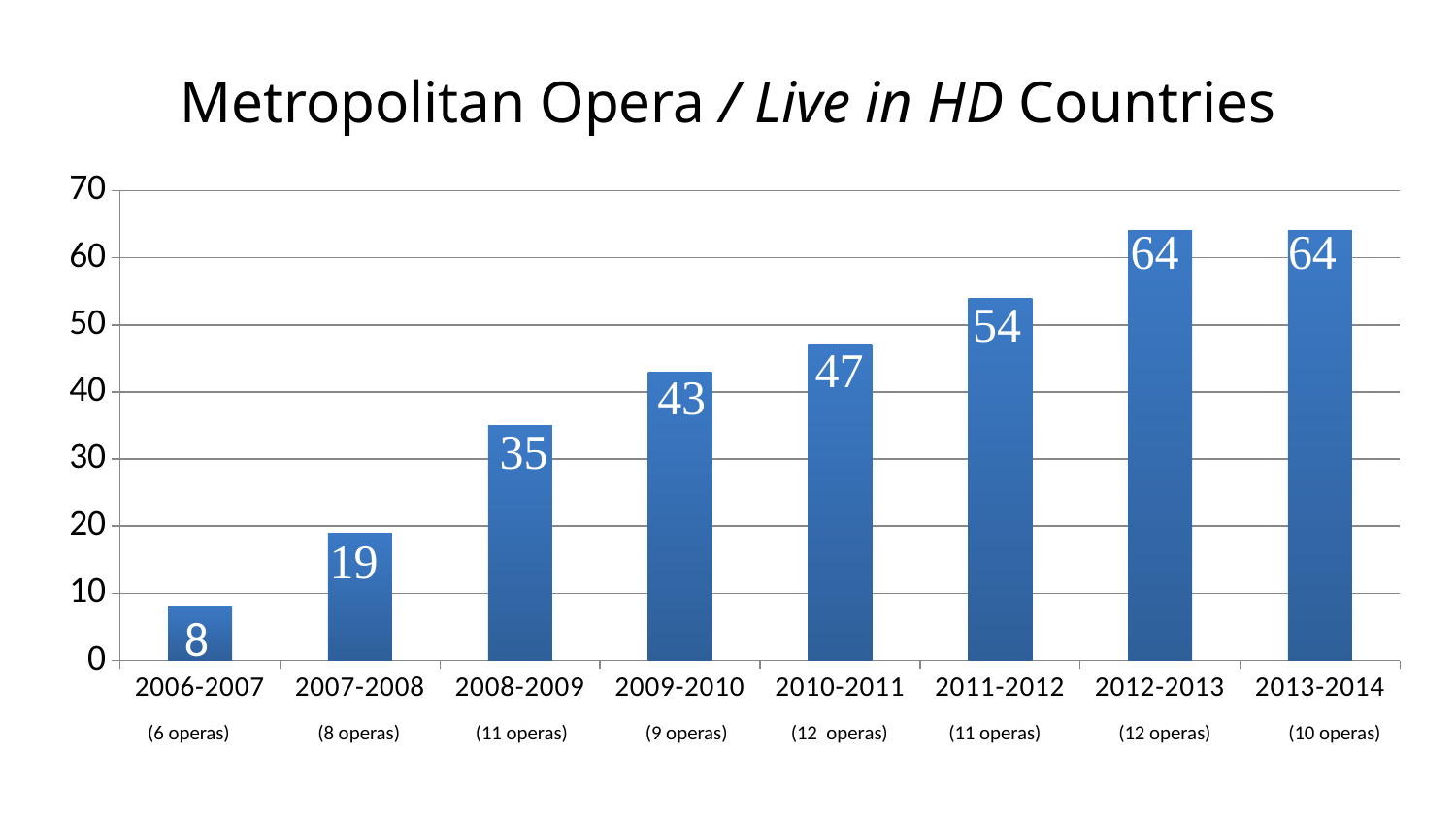
How many seasons are shown on the x axis? 8 What is the difference between the values for 2012-2013 and 2006-2007? 56 What is the value for 2011-2012? 54 Do the values generally rise or fall from 2006-2007 to 2013-2014? rise Which is larger, the value for 2007-2008 or the value for 2008-2009? 2008-2009 Is the value for 2011-2012 greater or less than 50? greater Which season has the lowest value? 2006-2007 What is the value for 2006-2007? 8 What is the title of the chart? Metropolitan Opera / Live in HD Countries What is the difference between the values for 2010-2011 and 2009-2010? 4 What is the value for 2008-2009? 35 What kind of chart is shown on the slide? bar chart